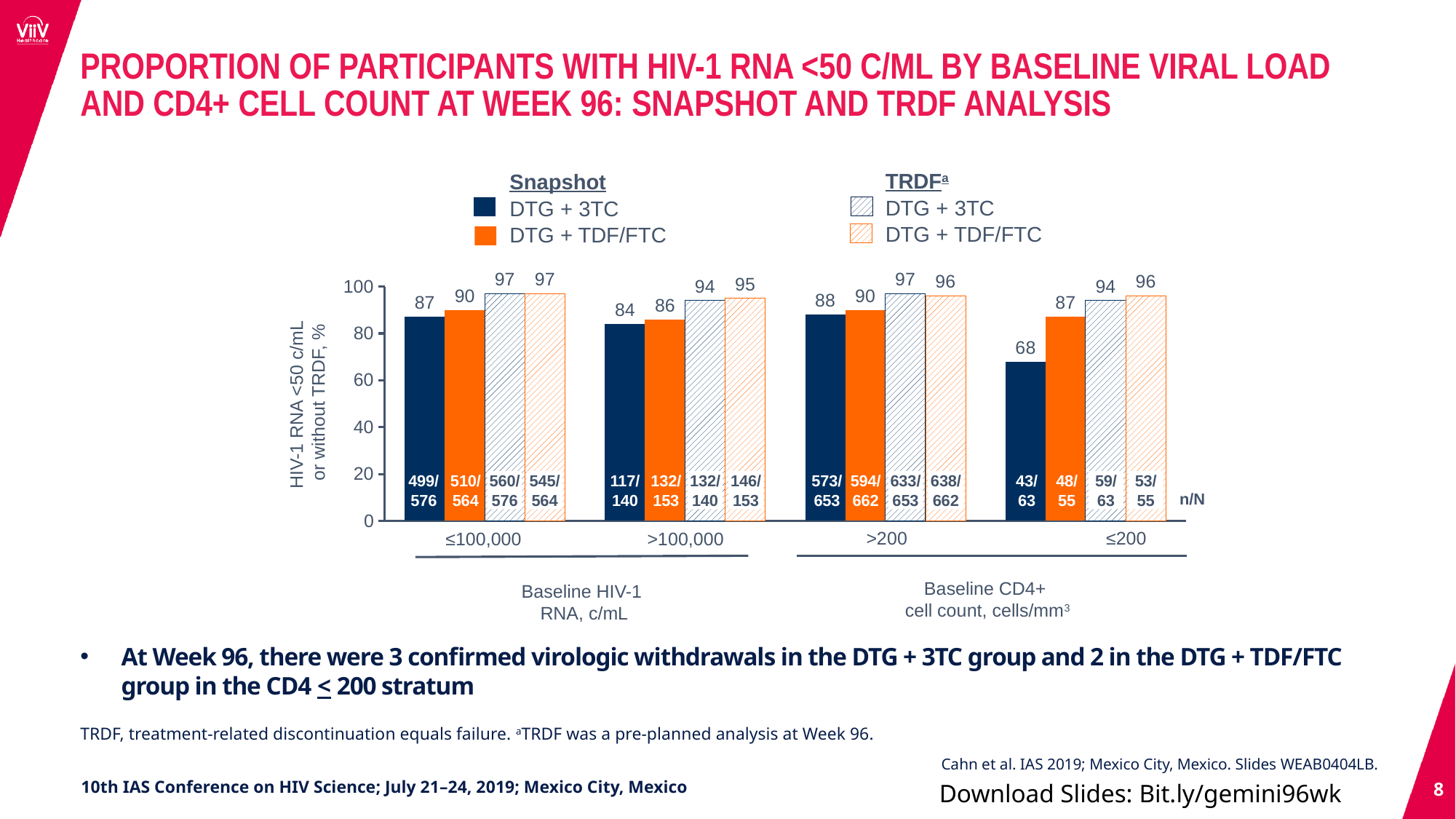
How many baseline subgroup categories are shown on the x axis of the chart? 4 Is the Snapshot DTG + 3TC value for the ≤200 baseline CD4+ cell count group greater or less than 80? less What is the Snapshot DTG + TDF/FTC value for the ≤200 baseline CD4+ cell count group? 87 What is the Snapshot DTG + 3TC value for the ≤100,000 baseline HIV-1 RNA group? 87 Which bar in the chart has the lowest value? Snapshot DTG + 3TC in the ≤200 CD4+ group (68) What kind of chart is shown on the slide? Bar chart How many series does the legend list in total? 4 In the >100,000 baseline HIV-1 RNA group, which is larger: the Snapshot DTG + 3TC value or the Snapshot DTG + TDF/FTC value? Snapshot DTG + TDF/FTC What is the TRDF DTG + 3TC value for the >200 baseline CD4+ cell count group? 97 What is the n/N shown for Snapshot DTG + 3TC in the ≤200 baseline CD4+ cell count group? 43/63 What is the difference between the TRDF DTG + 3TC and Snapshot DTG + 3TC values in the >100,000 baseline HIV-1 RNA group? 10 What is the difference between the Snapshot DTG + TDF/FTC and Snapshot DTG + 3TC values in the ≤200 baseline CD4+ cell count group? 19